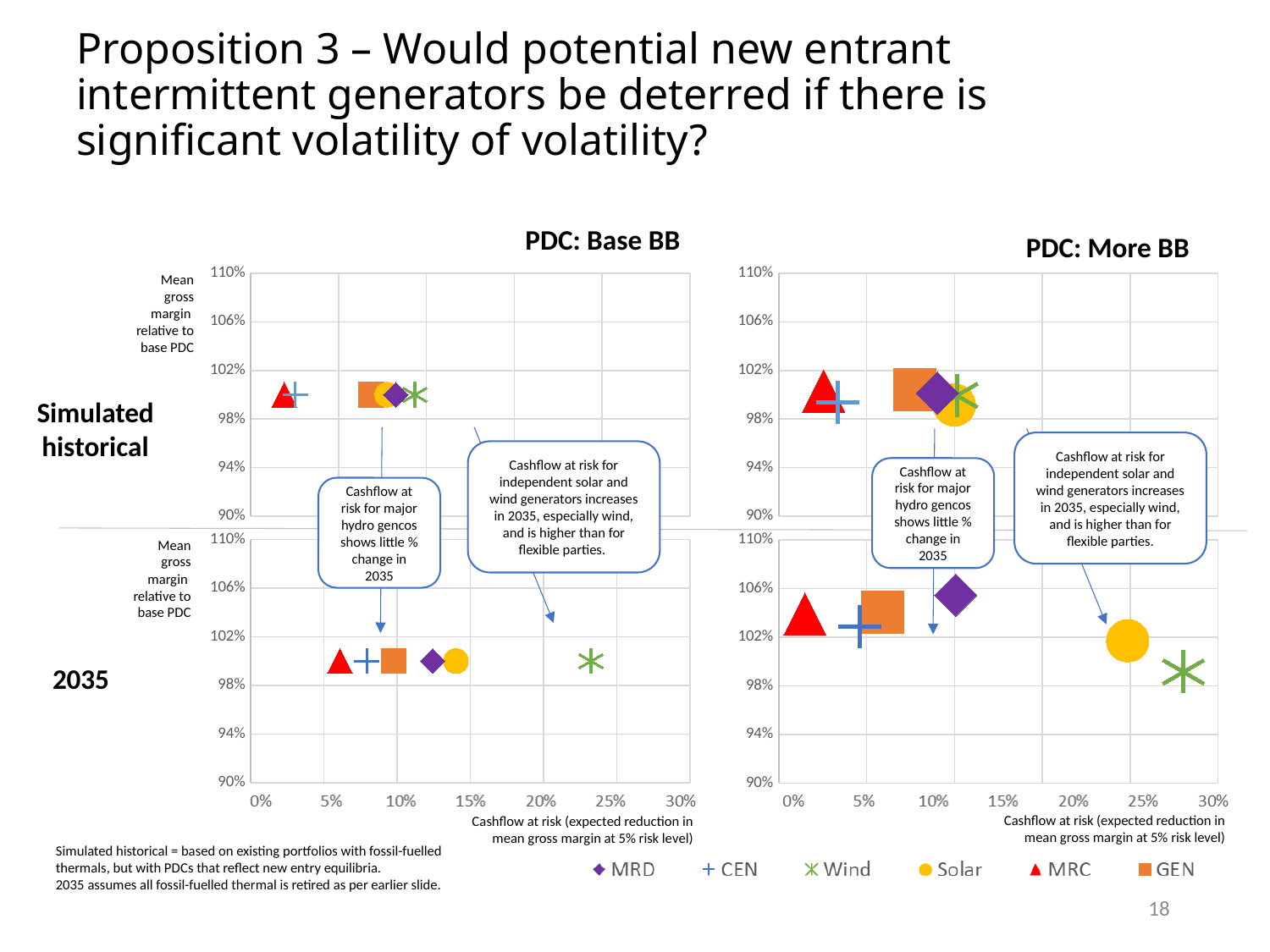
In the PDC: Base BB 2035 chart, is the cashflow at risk for Wind greater or less than 20%? greater Which series are listed in the legend? MRD, CEN, Wind, Solar, MRC, GEN What kind of chart is used on this slide? Scatter chart In the PDC: Base BB 2035 chart, is the cashflow at risk for MRC greater or less than 10%? less In the PDC: More BB 2035 chart, which has the larger cashflow at risk, Solar or MRD? Solar What is the x-axis label of the charts? Cashflow at risk (expected reduction in mean gross margin at 5% risk level) In the PDC: More BB 2035 chart, is the cashflow at risk for Wind greater or less than 25%? greater In the PDC: Base BB 2035 chart, which series has the highest cashflow at risk? Wind How many series does the legend list? 6 In the PDC: More BB 2035 chart, which series has the highest cashflow at risk? Wind In the PDC: Base BB 2035 chart, which series has the lowest cashflow at risk? MRC